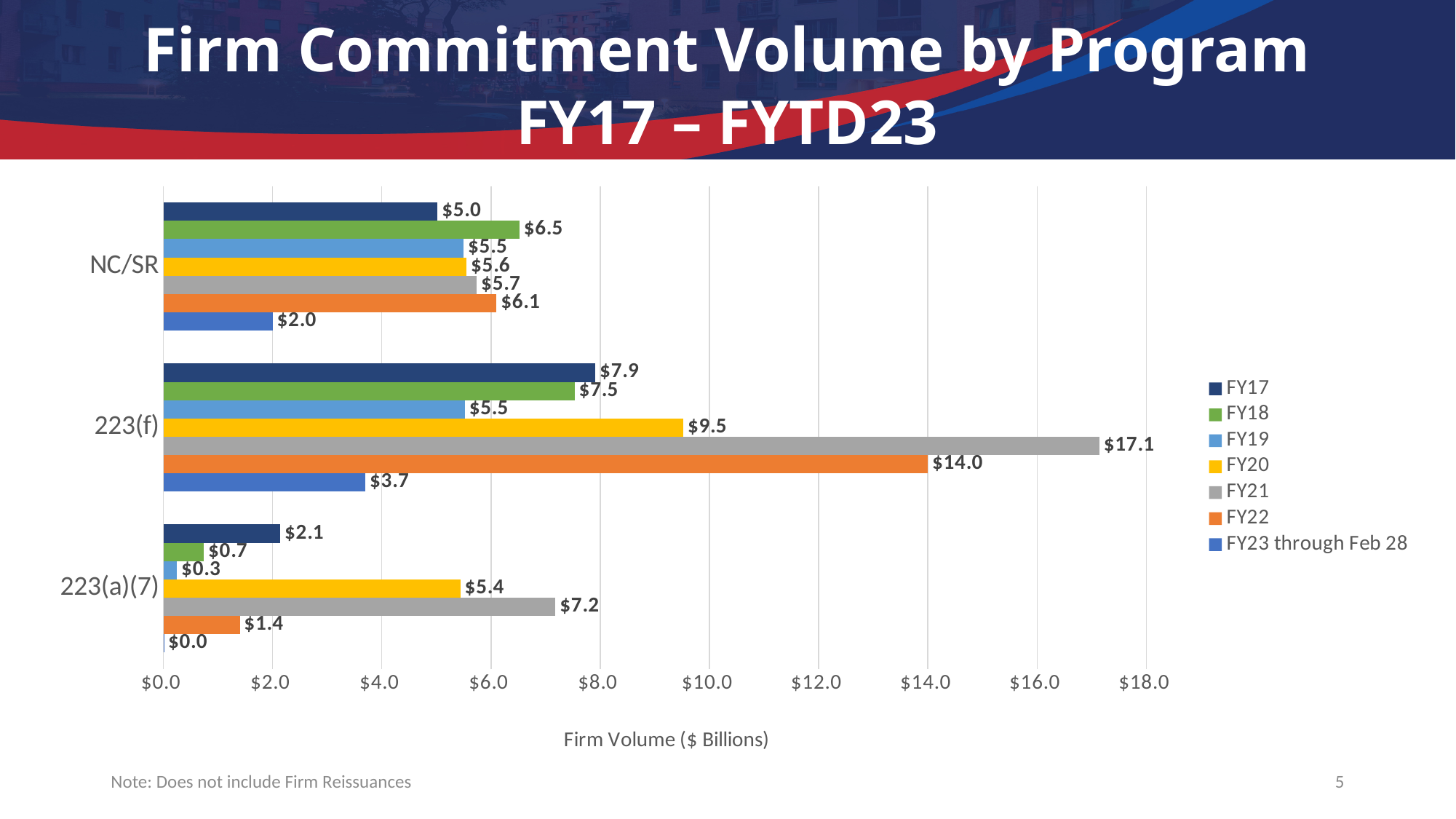
Which program has the lowest FY19 firm commitment volume? 223(a)(7) What is the label of the horizontal axis? Firm Volume ($ Billions) How many series does the legend list? 7 How many programs are shown on the chart? 3 What kind of chart is shown on the slide? Bar chart What is the FY17 firm commitment volume for NC/SR? $5.0 Which is larger for NC/SR: the FY18 value or the FY22 value? FY18 Which legend entry is represented by the grey bars? FY21 What is the FY22 firm commitment volume for 223(a)(7)? $1.4 Which program has the highest FY21 firm commitment volume? 223(f) What is the FY21 firm commitment volume for 223(f)? $17.1 What is the difference between the FY21 and FY22 firm commitment volumes for 223(f)? $3.1